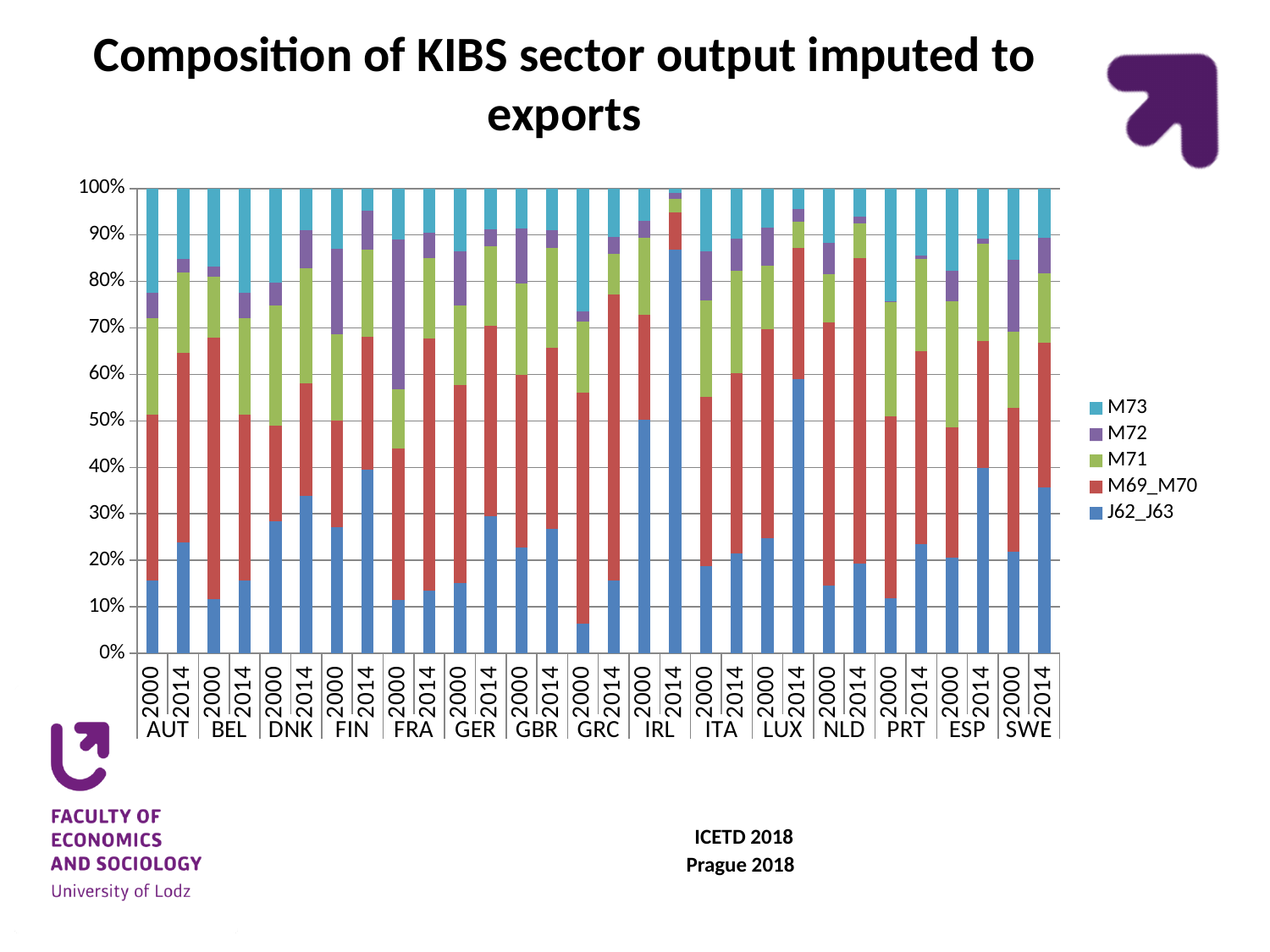
Is the J62_J63 share for GRC 2000 greater or less than 10%? less Which has the larger J62_J63 share, AUT 2000 or AUT 2014? AUT 2014 How many series does the legend list? 5 What is the title of the chart? Composition of KIBS sector output imputed to exports Is the J62_J63 share for LUX 2014 greater or less than 50%? greater Is the J62_J63 share for IRL 2014 greater or less than 80%? greater Which bar has the smallest J62_J63 share? GRC 2000 Which bar has the largest J62_J63 share? IRL 2014 How many bars are plotted in the chart? 30 How many countries are shown along the x axis? 15 What kind of chart is shown on the slide? Stacked bar chart Which series is plotted at the bottom of each stacked bar? J62_J63